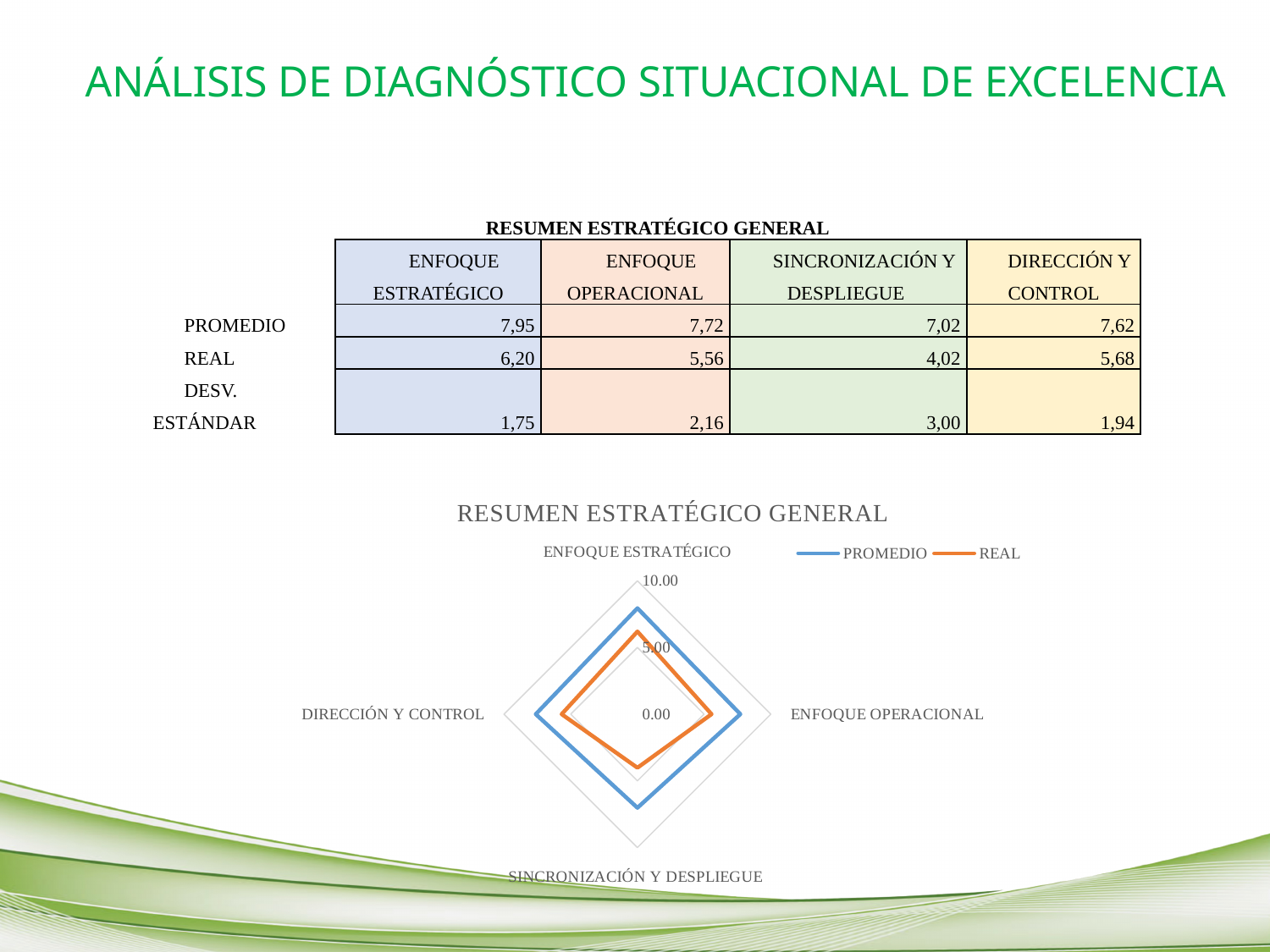
How many categories (axes) does the radar chart have? 4 Is the REAL value for SINCRONIZACIÓN Y DESPLIEGUE greater or less than 5.00? less What is the REAL value for SINCRONIZACIÓN Y DESPLIEGUE? 4,02 What is the PROMEDIO value for ENFOQUE ESTRATÉGICO? 7,95 Which category has the lowest REAL value? SINCRONIZACIÓN Y DESPLIEGUE Which series is drawn in orange on the radar chart? REAL What is the title of the radar chart? RESUMEN ESTRATÉGICO GENERAL What kind of chart is shown on the slide? Radar chart Which category has the highest PROMEDIO value? ENFOQUE ESTRATÉGICO What is the difference between the PROMEDIO and REAL values for ENFOQUE ESTRATÉGICO? 1,75 How many series does the legend of the radar chart list? 2 For DIRECCIÓN Y CONTROL, which series has the larger value, PROMEDIO or REAL? PROMEDIO